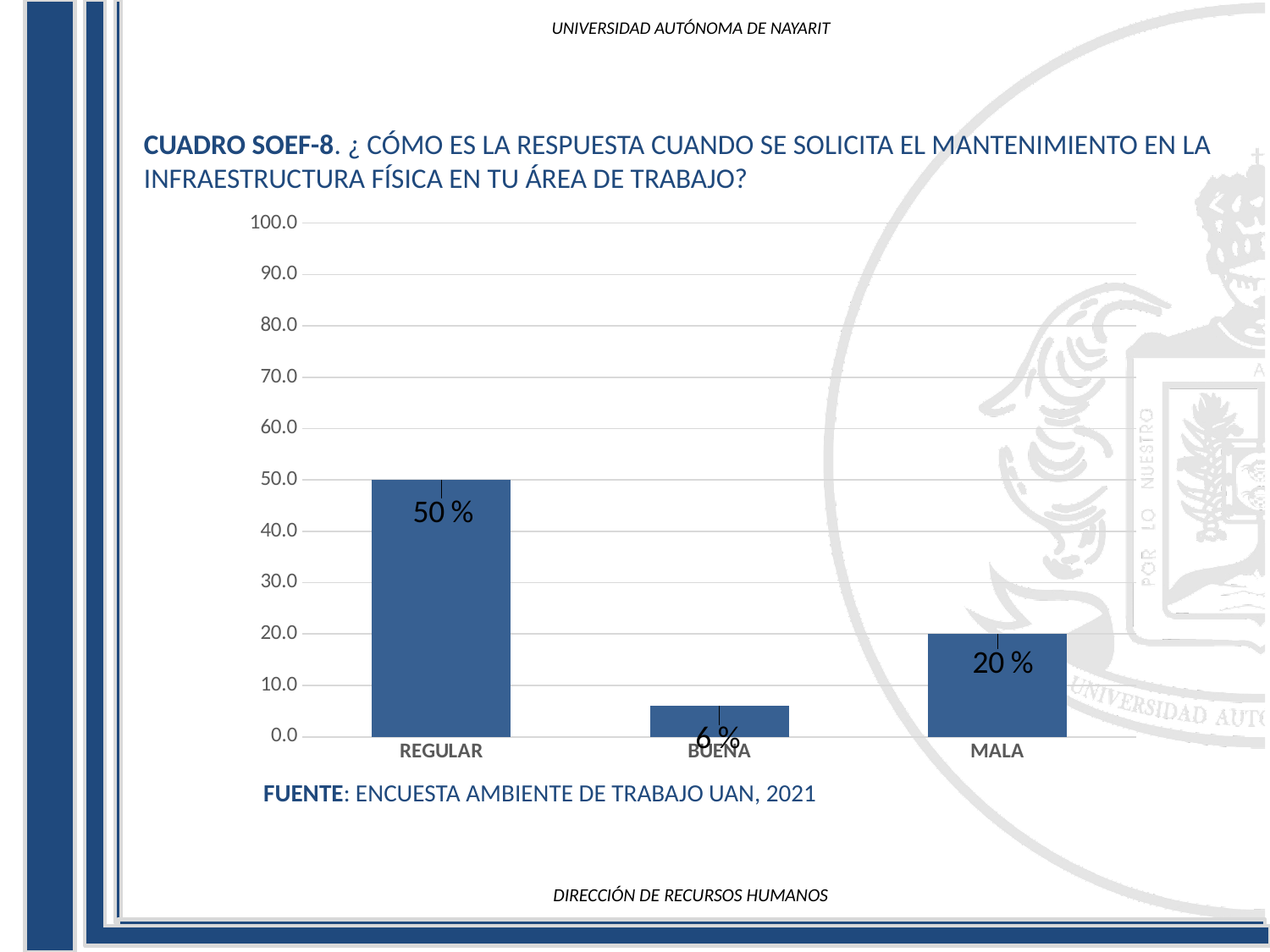
How many categories are shown on the x axis? 3 What is the difference between the values for MALA and BUENA? 14 % Which category has the lowest value? BUENA Which is larger, the value for MALA or the value for BUENA? MALA What kind of chart is shown on the slide? bar chart What is the difference between the values for REGULAR and MALA? 30 % What is the value for MALA? 20 % What is the value for REGULAR? 50 % Is the value for REGULAR greater or less than 40.0? greater Which category has the highest value? REGULAR What source is cited below the chart? ENCUESTA AMBIENTE DE TRABAJO UAN, 2021 What is the value for BUENA? 6 %